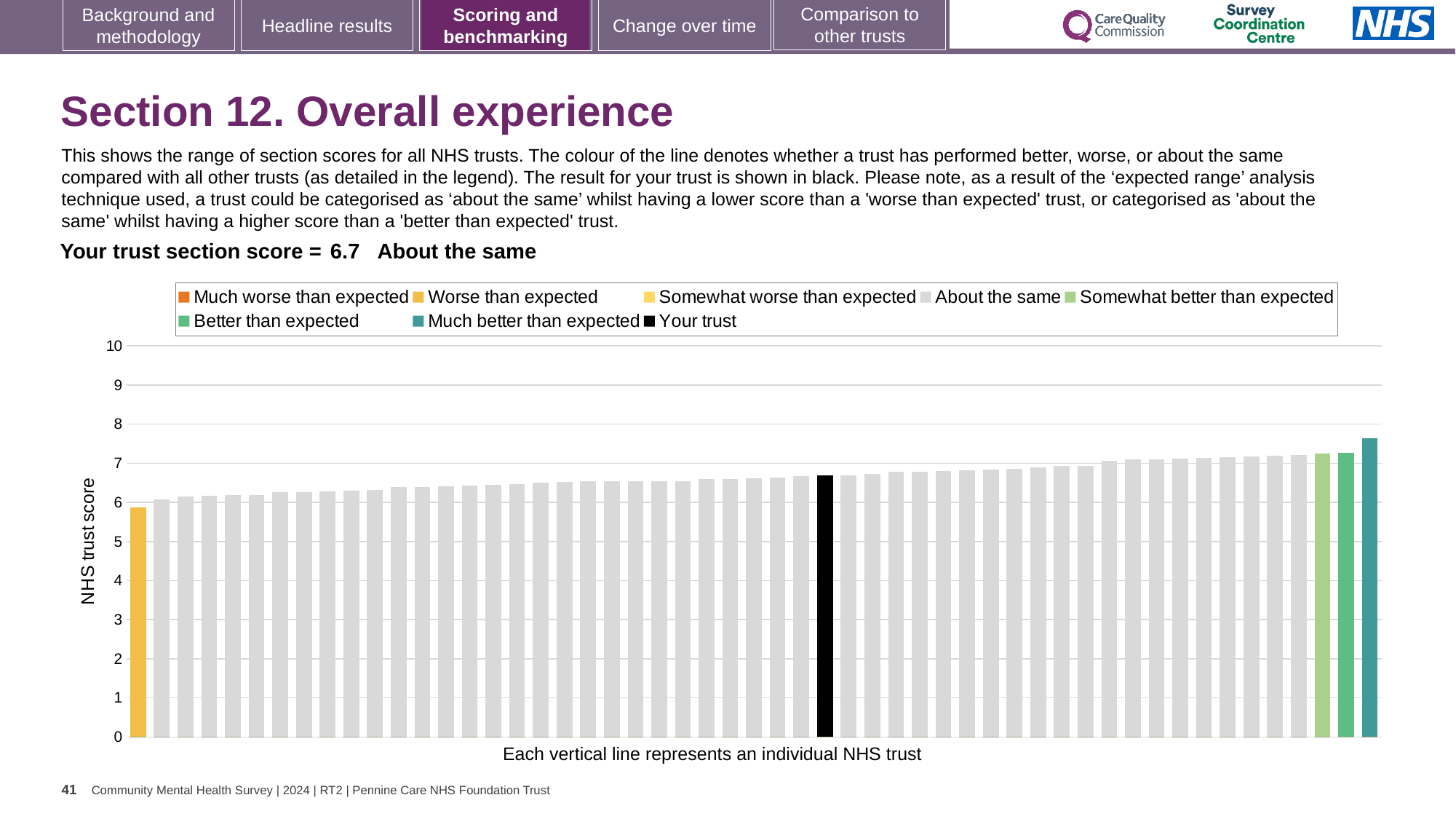
Which legend category does the tallest bar in the chart belong to? Much better than expected Is the value of the black 'Your trust' bar greater or less than 6? greater What kind of chart is shown on the slide? bar chart How many entries does the chart legend list? 8 Do the bar values rise or fall moving from left to right along the x axis? rise Is the value of the leftmost yellow 'Worse than expected' bar greater or less than 5? greater Is the value of the tallest bar (the 'Much better than expected' trust) greater or less than 8? less What is the label on the vertical axis of the chart? NHS trust score Which legend category does the shortest bar in the chart belong to? Worse than expected What is the section score for your trust shown on the slide? 6.7